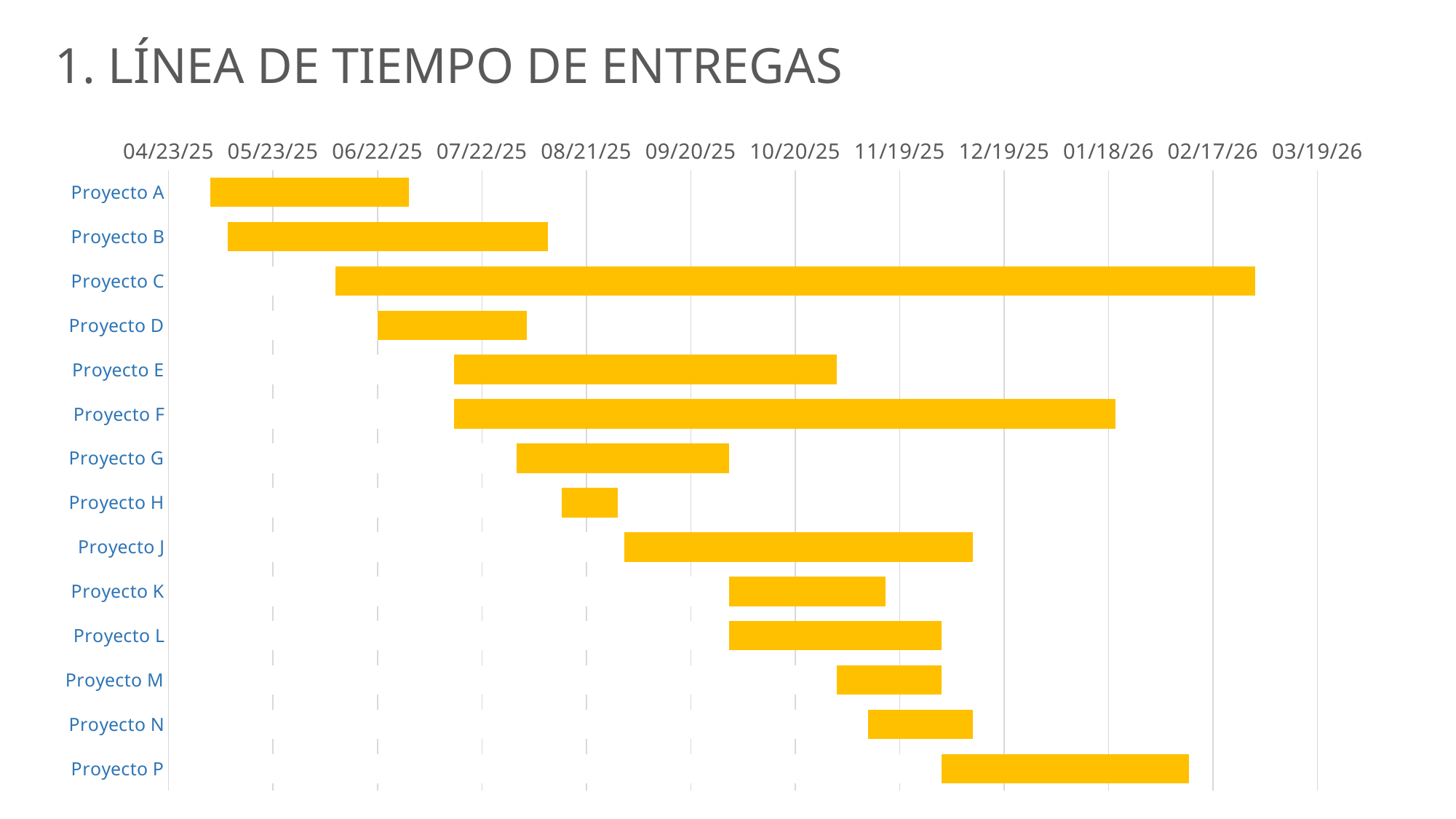
Which bar is longer, Proyecto F or Proyecto D? Proyecto F Does the bar for Proyecto A end before or after the 07/22/25 axis tick? before Which project has the longest bar in the chart? Proyecto C Which bar is longer, Proyecto J or Proyecto K? Proyecto J How many projects are listed on the vertical axis of the chart? 14 What is the title of the slide containing the chart? 1. LÍNEA DE TIEMPO DE ENTREGAS Which project has the shortest bar in the chart? Proyecto H What is the first date label shown on the horizontal axis? 04/23/25 Which project's bar starts earliest on the timeline? Proyecto A What kind of chart is shown on the slide? Bar chart (Gantt-style horizontal bars) Which project's bar ends latest on the timeline? Proyecto C Does the bar for Proyecto P start before or after the 12/19/25 axis tick? before